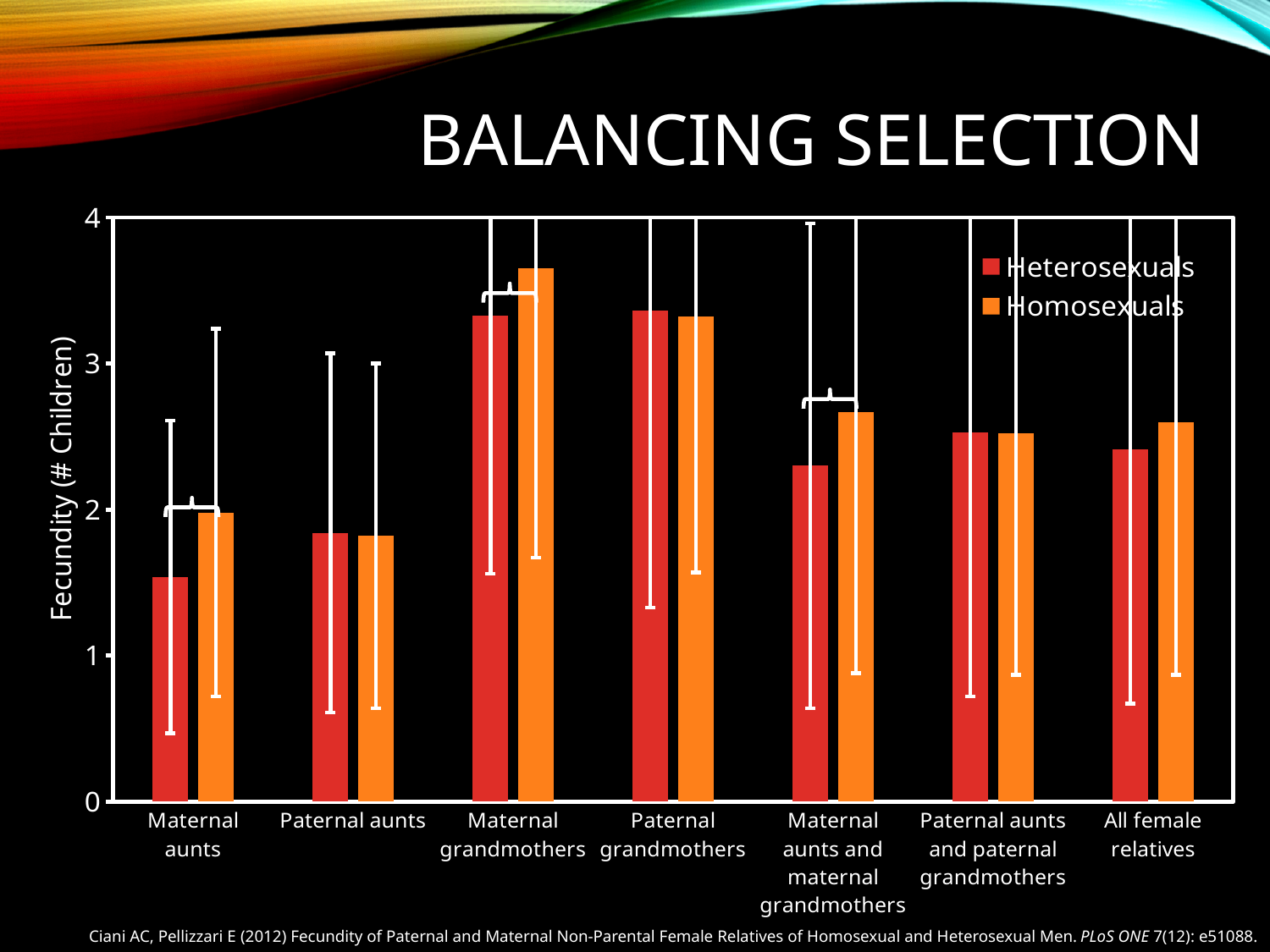
What kind of chart is shown on the slide? Bar chart Is the Heterosexuals value for Maternal aunts and maternal grandmothers greater or less than 2? greater For Maternal grandmothers, which series has the larger value, Heterosexuals or Homosexuals? Homosexuals Which category has the highest value for Homosexuals? Maternal grandmothers Is the Homosexuals value for Maternal grandmothers greater or less than 3? greater Is the Heterosexuals value for Maternal aunts greater or less than 2? less For Maternal aunts, which series has the larger value, Heterosexuals or Homosexuals? Homosexuals What is the label on the y axis of the chart? Fecundity (# Children) How many series does the legend list? 2 Which category has the lowest value for Heterosexuals? Maternal aunts How many categories of female relatives are shown on the x axis? 7